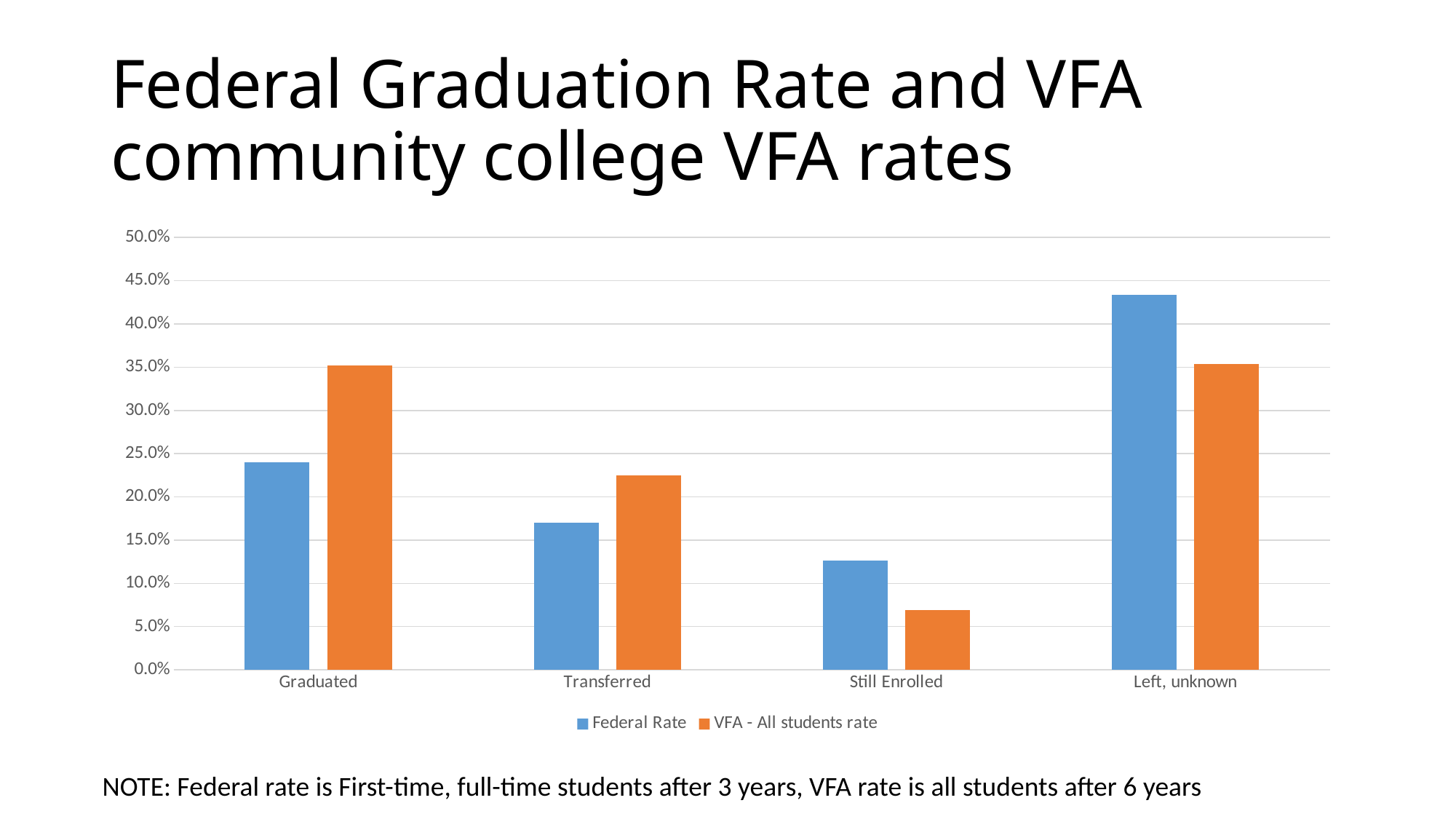
Is the Federal Rate for Left, unknown greater or less than 40.0%? greater How many categories are shown on the x axis? 4 Is the VFA - All students rate for Graduated greater or less than 30.0%? greater Which category has the lowest Federal Rate? Still Enrolled Is the VFA - All students rate for Still Enrolled greater or less than 10.0%? less What kind of chart is shown on the slide? bar chart Which category has the lowest VFA - All students rate? Still Enrolled For Still Enrolled, which is larger: the Federal Rate or the VFA - All students rate? Federal Rate What are the two series named in the legend? Federal Rate and VFA - All students rate Which category has the highest Federal Rate? Left, unknown How many series does the legend list? 2 For Graduated, which is larger: the Federal Rate or the VFA - All students rate? VFA - All students rate